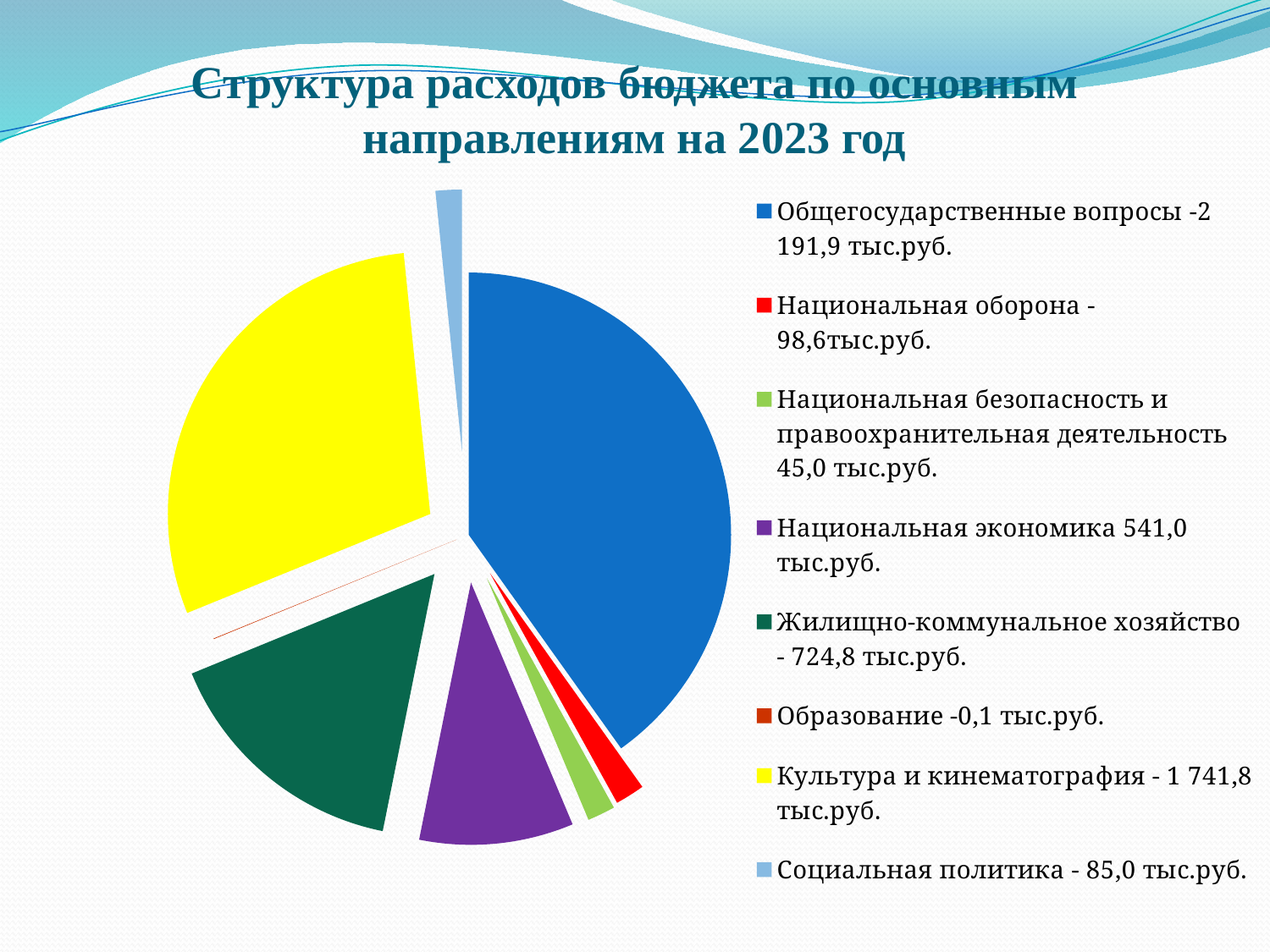
What kind of chart is shown on the slide? pie chart What is the value for Общегосударственные вопросы? 2 191,9 тыс.руб. Which category has the largest share of the pie? Общегосударственные вопросы What is the value for Культура и кинематография? 1 741,8 тыс.руб. Which is larger: Жилищно-коммунальное хозяйство or Национальная экономика? Жилищно-коммунальное хозяйство Which category has the smallest value? Образование What is the value for Социальная политика? 85,0 тыс.руб. What is the value for Жилищно-коммунальное хозяйство? 724,8 тыс.руб. What colour is the slice for Культура и кинематография? yellow What is the difference between Жилищно-коммунальное хозяйство and Национальная экономика? 183,8 тыс.руб. What is the difference between Общегосударственные вопросы and Культура и кинематография? 450,1 тыс.руб. How many categories does the pie chart have? 8